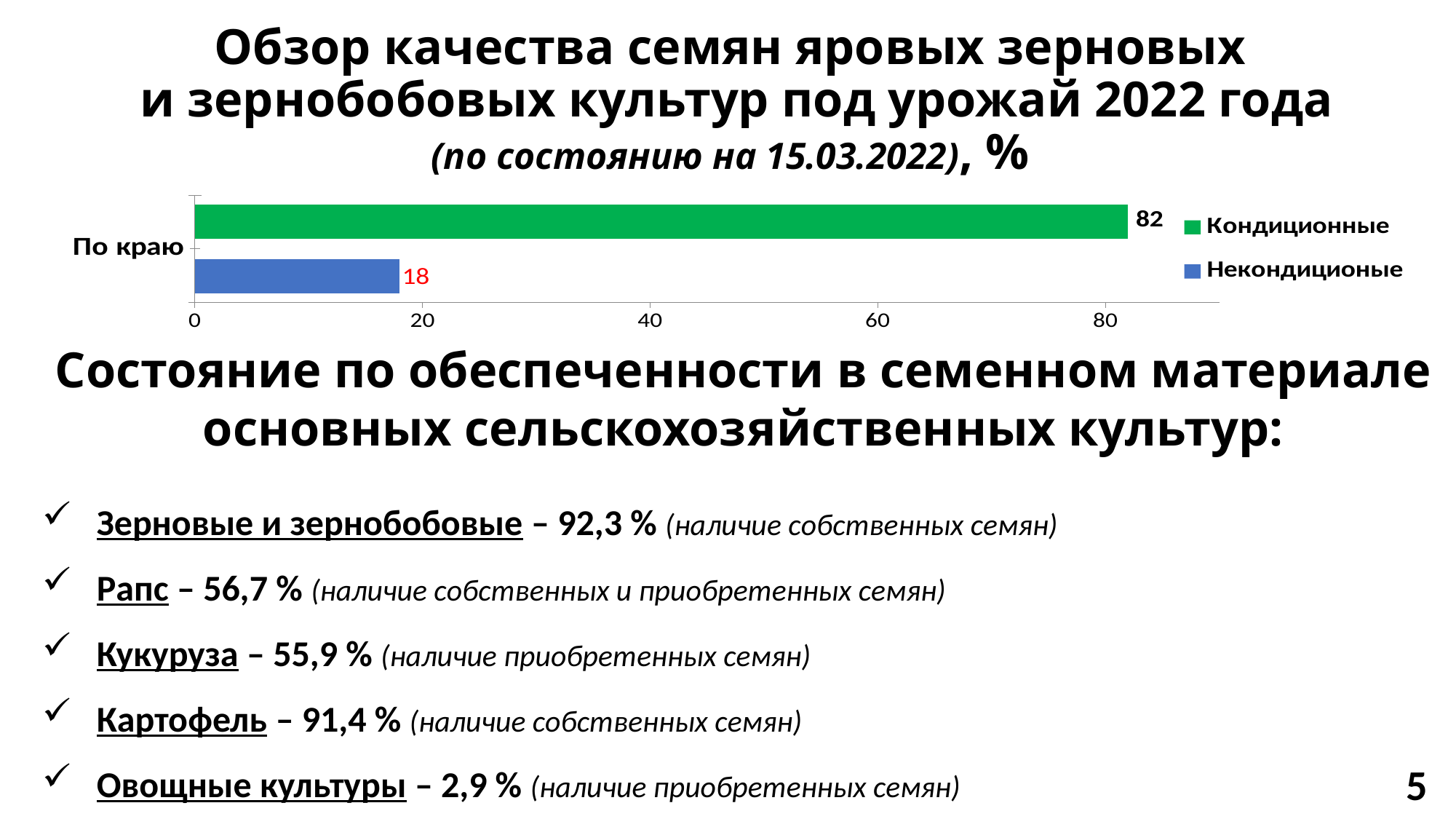
What kind of chart is shown on the slide? bar chart Is the value for Некондиционые greater or less than 20? less What is the label of the category shown on the chart? По краю Which series has the higher value for По краю, Кондиционные or Некондиционые? Кондиционные How many series does the legend list? 2 Is the value for Кондиционные greater or less than 80? greater What is the value for Некондиционые for По краю? 18 What is the difference between the Кондиционные and Некондиционые values for По краю? 64 What colour is the bar for Кондиционные? green What is the total of the Кондиционные and Некондиционые values for По краю? 100 What is the value for Кондиционные for По краю? 82 How many categories are shown on the chart? 1